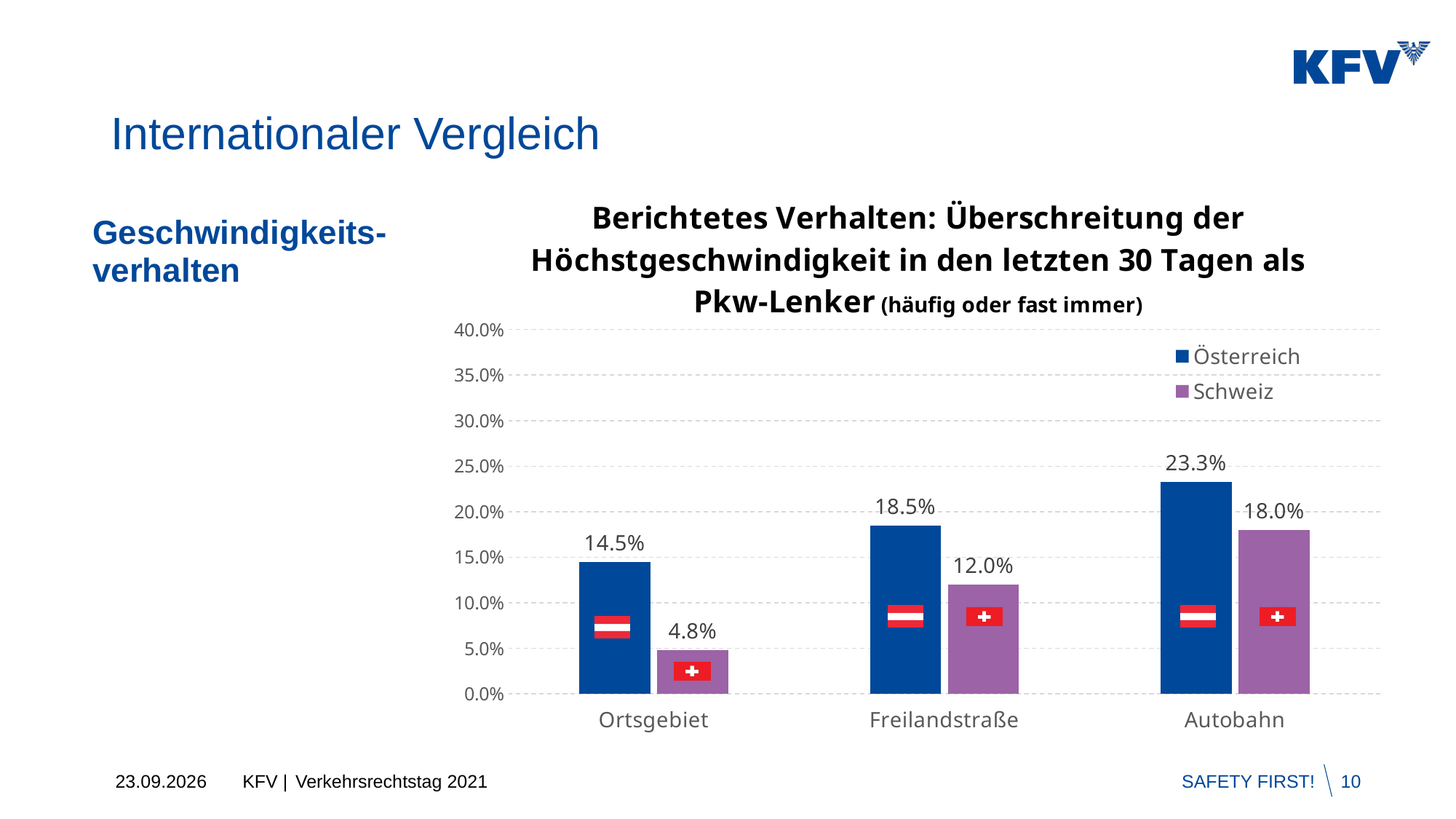
How many series does the legend list? 2 Which is larger in the Freilandstraße category, Österreich or Schweiz? Österreich What is the value for Schweiz in the Ortsgebiet category? 4.8% In which category does Österreich have its highest value? Autobahn What is the difference between the Österreich and Schweiz values in the Autobahn category? 5.3% What is the value for Schweiz in the Freilandstraße category? 12.0% Do the Schweiz values rise or fall from Ortsgebiet to Autobahn? Rise How many categories are shown on the x axis? 3 What is the value for Österreich in the Autobahn category? 23.3% What kind of chart is shown on the slide? Bar chart In which category does Schweiz have its lowest value? Ortsgebiet What is the value for Österreich in the Ortsgebiet category? 14.5%